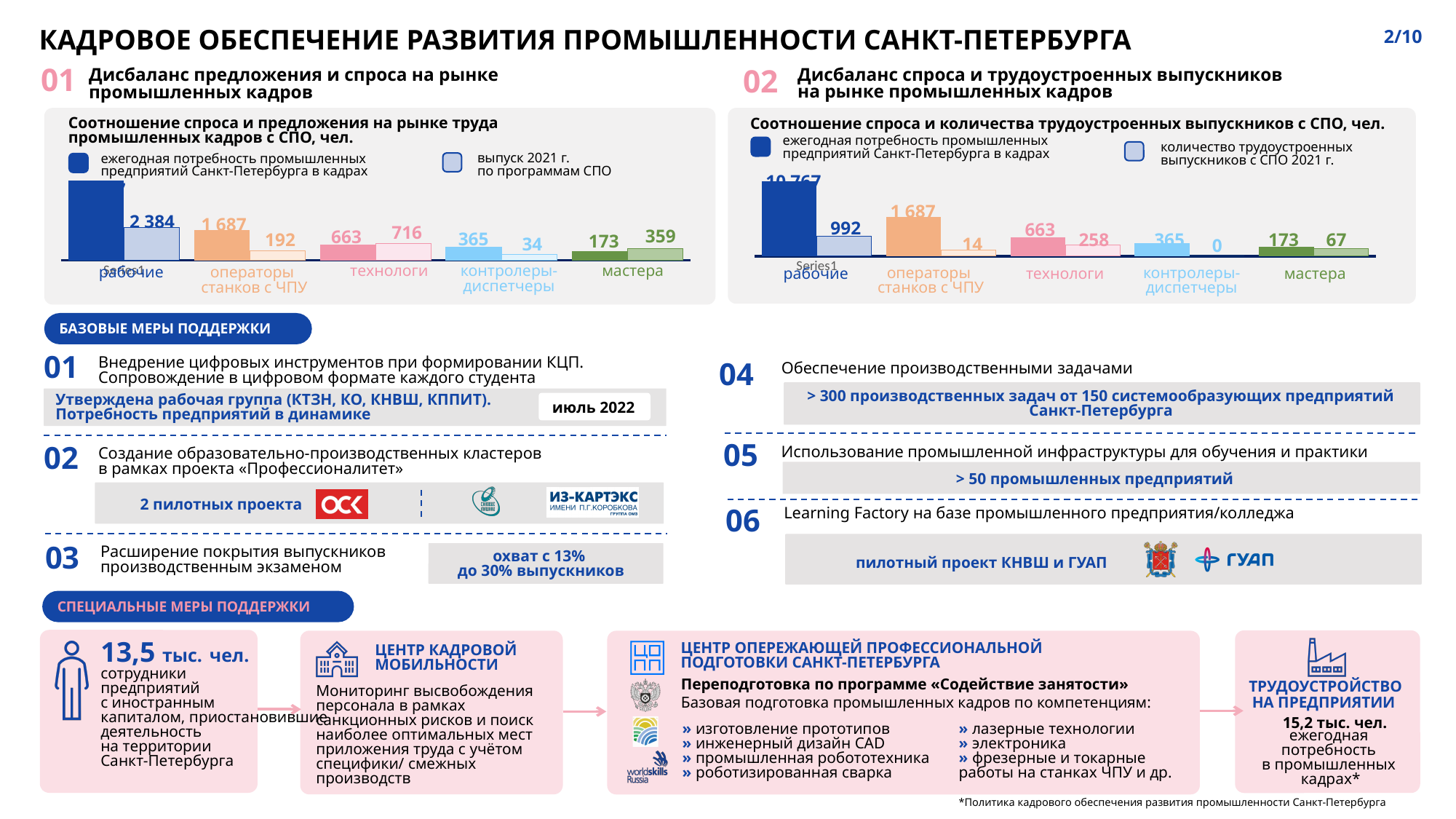
What type of chart is used in the right chart (Соотношение спроса и количества трудоустроенных выпускников с СПО)? bar chart In the right chart (Соотношение спроса и количества трудоустроенных выпускников с СПО), which category has the lowest number of employed graduates? контролеры-диспетчеры In the right chart (Соотношение спроса и количества трудоустроенных выпускников с СПО), what is the number of employed graduates (количество трудоустроенных выпускников) for рабочие? 992 In the right chart (Соотношение спроса и количества трудоустроенных выпускников с СПО), what is the difference between ежегодная потребность and количество трудоустроенных выпускников for технологи? 405 In the right chart (Соотношение спроса и количества трудоустроенных выпускников с СПО), what is the number of employed graduates for операторы станков с ЧПУ? 14 In the left chart (Соотношение спроса и предложения на рынке труда промышленных кадров с СПО), what is the value of выпуск 2021 г. по программам СПО for рабочие? 2 384 In the left chart (Соотношение спроса и предложения на рынке труда промышленных кадров с СПО), what is the difference between выпуск 2021 г. and ежегодная потребность for технологи? 53 In the left chart (Соотношение спроса и предложения на рынке труда промышленных кадров с СПО), how many categories are shown on the x axis? 5 In the right chart (Соотношение спроса и количества трудоустроенных выпускников с СПО), how many series does the legend list? 2 In the left chart (Соотношение спроса и предложения на рынке труда промышленных кадров с СПО), what is the annual need (ежегодная потребность) for операторы станков с ЧПУ? 1 687 In the left chart (Соотношение спроса и предложения на рынке труда промышленных кадров с СПО), what is the value of выпуск 2021 г. for контролеры-диспетчеры? 34 In the left chart (Соотношение спроса и предложения на рынке труда промышленных кадров с СПО), which is larger for мастера: ежегодная потребность or выпуск 2021 г.? выпуск 2021 г.